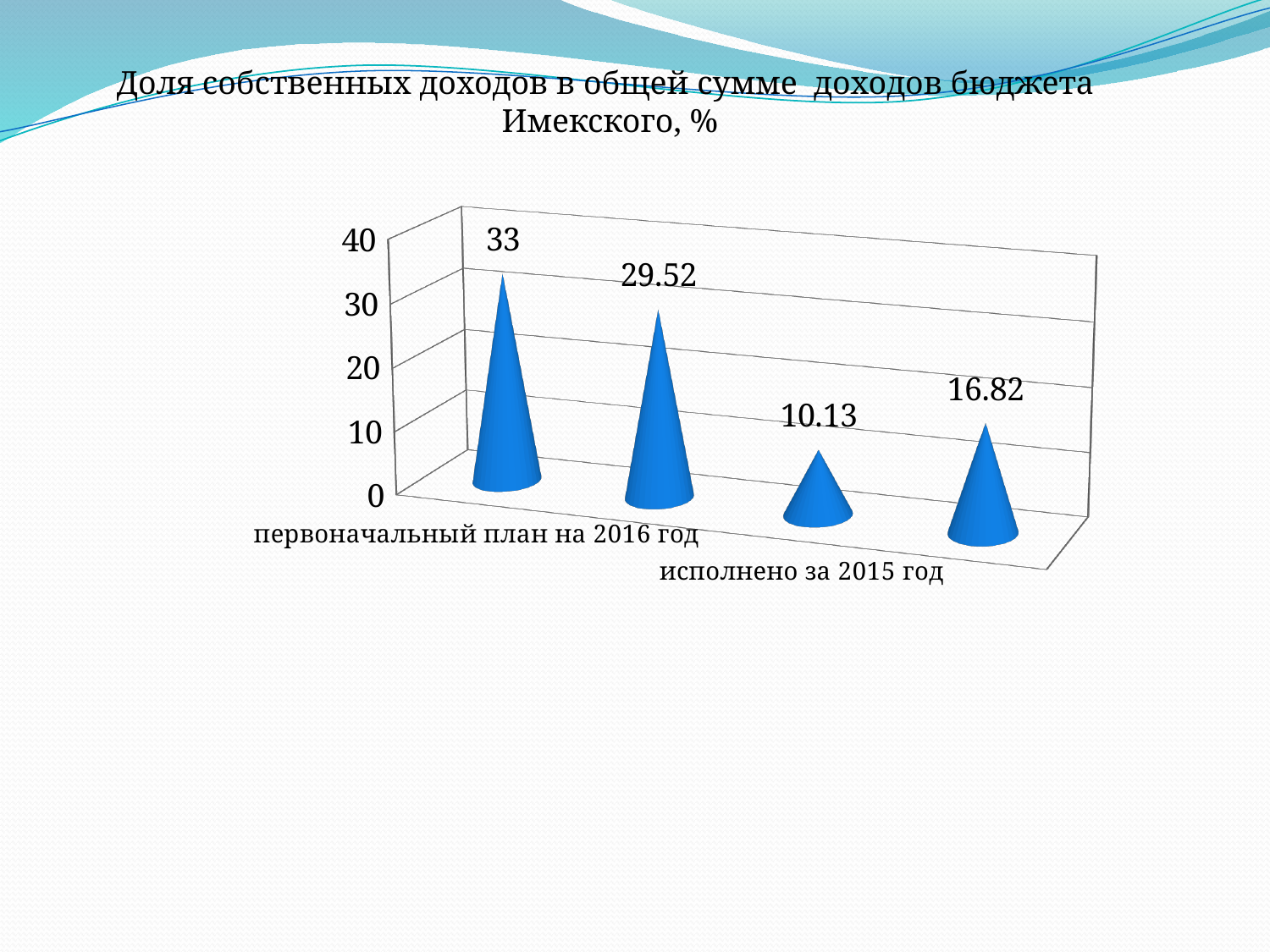
What is the lowest value shown in the chart? 10.13 Which is larger, the second bar or the fourth bar? the second bar (29.52) What is the difference between the first bar (33) and the second bar (29.52)? 3.48 What is the maximum value shown on the vertical axis? 40 What type of chart is shown on the slide? bar chart Is the value of the first bar greater or less than 30? greater What is the value of the fourth bar from the left? 16.82 What is the value labelled for 'первоначальный план на 2016 год' (the first bar)? 33 What is the highest value shown in the chart? 33 What is the value of the second bar from the left? 29.52 What is the difference between the fourth bar (16.82) and the third bar (10.13)? 6.69 How many bars are plotted in the chart? 4